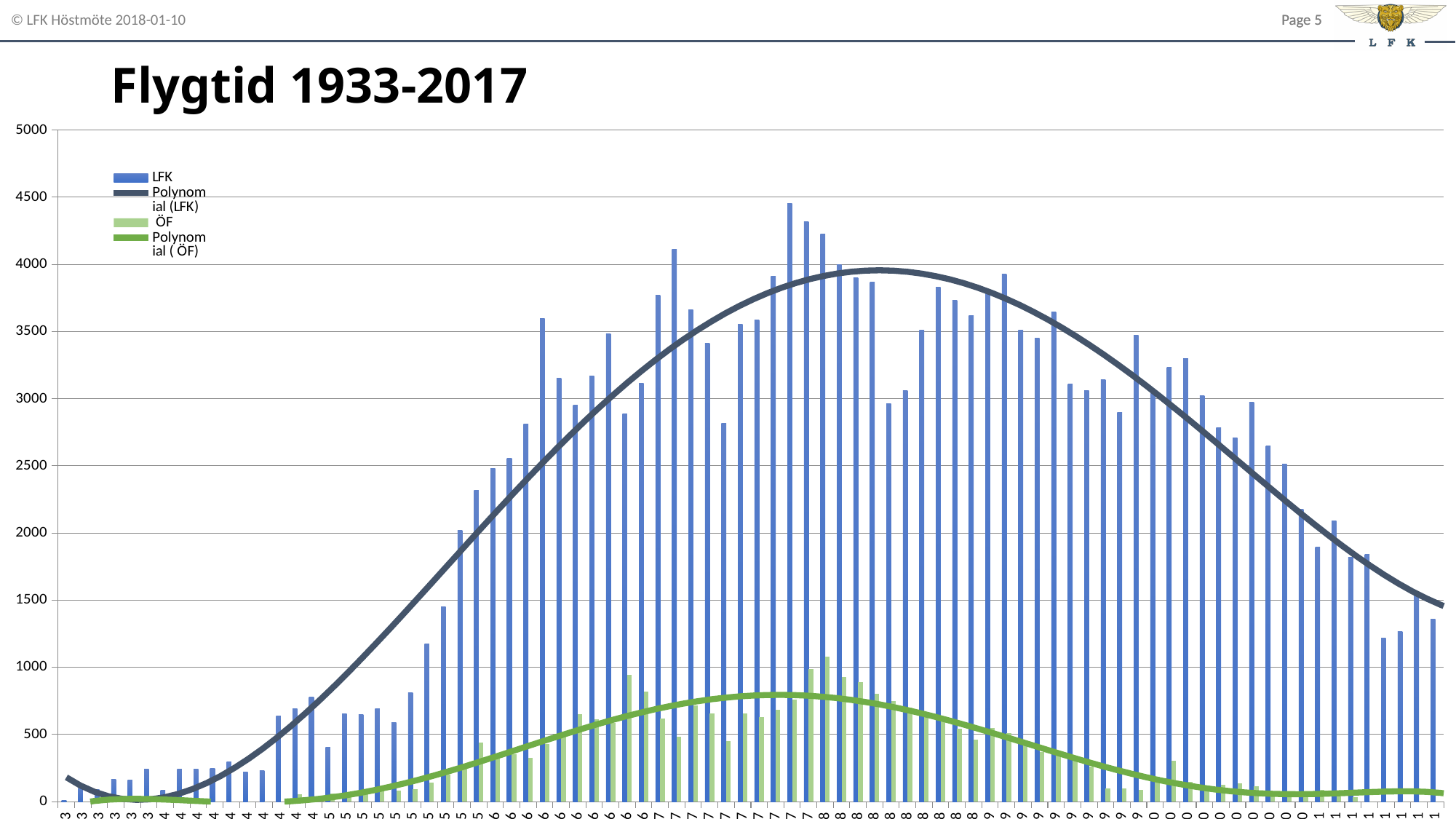
What colour are the ÖF bars in the chart? Light green Which bar series reaches the higher peak value, LFK or ÖF? LFK What is the highest value shown on the vertical axis? 5000 How many entries does the chart legend list? 4 Is the tallest LFK bar greater or less than 4000? greater How many bar series are plotted in the chart? 2 What kind of chart is shown on the slide? Bar chart Is the tallest ÖF bar greater or less than 1500? less Do the LFK bars generally rise, fall, or rise and then fall across the x axis from left to right? Rise and then fall Is the peak of the Polynomial (ÖF) trend line greater or less than 1000? less What is the title of the chart? Flygtid 1933-2017